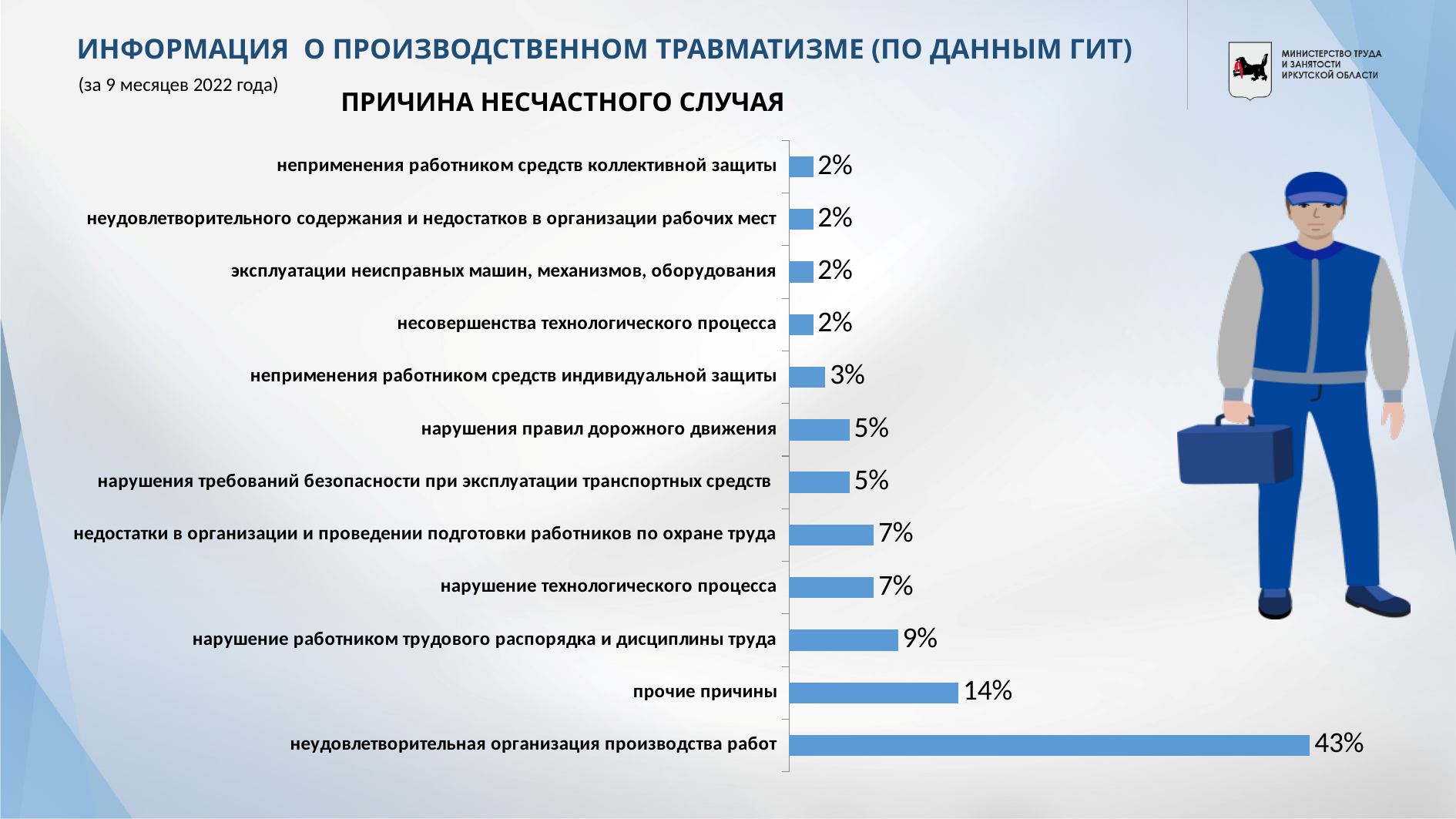
How many causes (categories) are shown in the chart? 12 What is the difference between «нарушение работником трудового распорядка и дисциплины труда» and «нарушения правил дорожного движения»? 4% What is the value for «прочие причины»? 14% Which cause has the highest value? неудовлетворительная организация производства работ How many categories have a value of 2%? 4 Which is larger: «нарушение технологического процесса» or «несовершенства технологического процесса»? нарушение технологического процесса What kind of chart is shown on the slide? bar chart What is the difference between «неудовлетворительная организация производства работ» and «прочие причины»? 29% What is the value for «неудовлетворительная организация производства работ»? 43% What is the title of the chart? ПРИЧИНА НЕСЧАСТНОГО СЛУЧАЯ What is the value for «нарушение работником трудового распорядка и дисциплины труда»? 9% What is the value for «неприменения работником средств индивидуальной защиты»? 3%